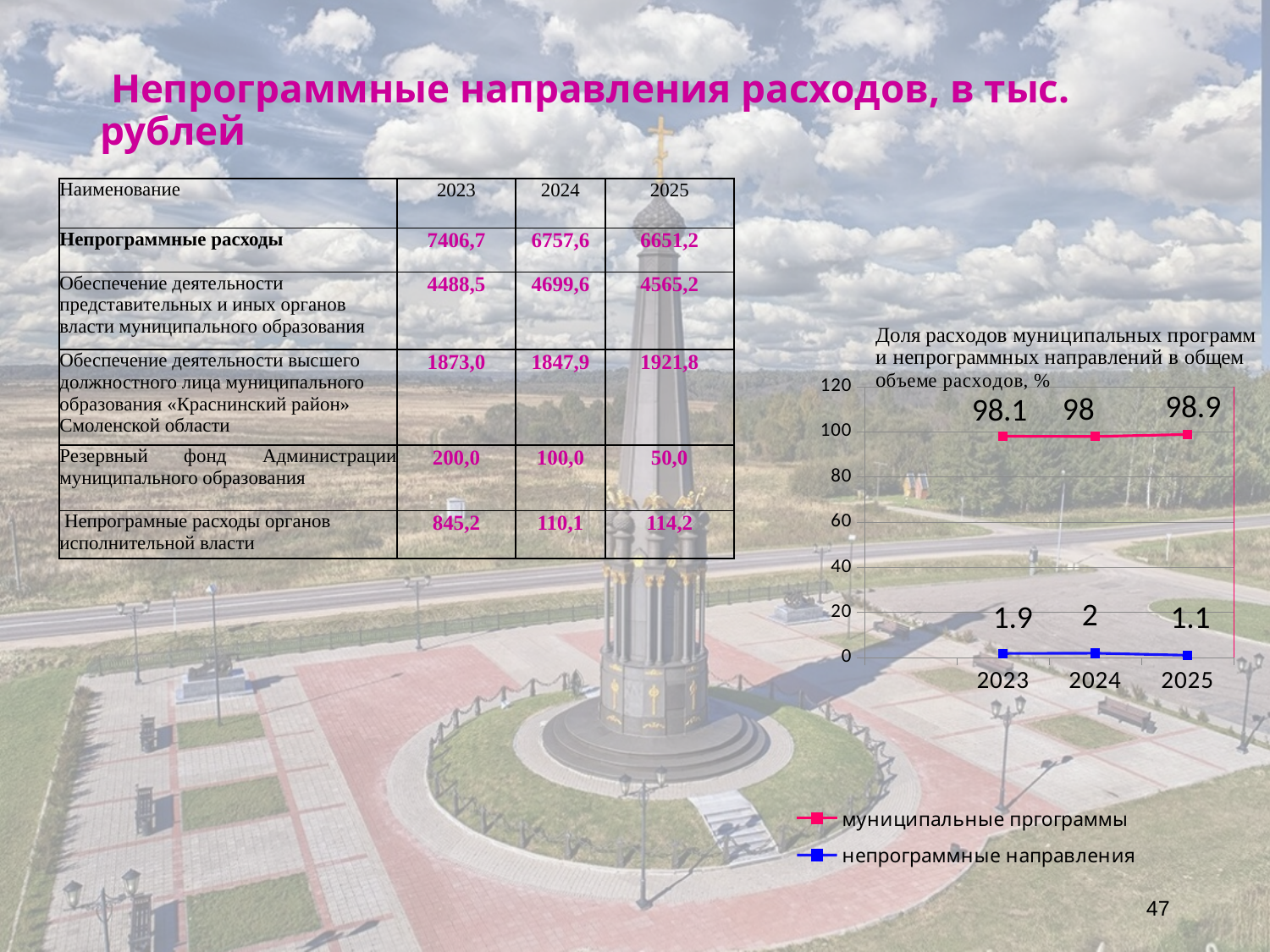
What is the difference between the муниципальные программы values for 2025 and 2024? 0.9 How many years are shown on the x axis of the chart? 3 Does the value for непрограммные направления rise or fall from 2024 to 2025? Fall What is the value for муниципальные программы in 2025? 98.9 What is the value for непрограммные направления in 2025? 1.1 Which series has the larger value in 2023, муниципальные программы or непрограммные направления? муниципальные программы How many series does the chart legend list? 2 In which year is the value for муниципальные программы the highest? 2025 What type of chart is shown on the slide? Line chart What is the value for непрограммные направления in 2024? 2 In which year is the value for непрограммные направления the lowest? 2025 What is the value for муниципальные программы in 2023? 98.1